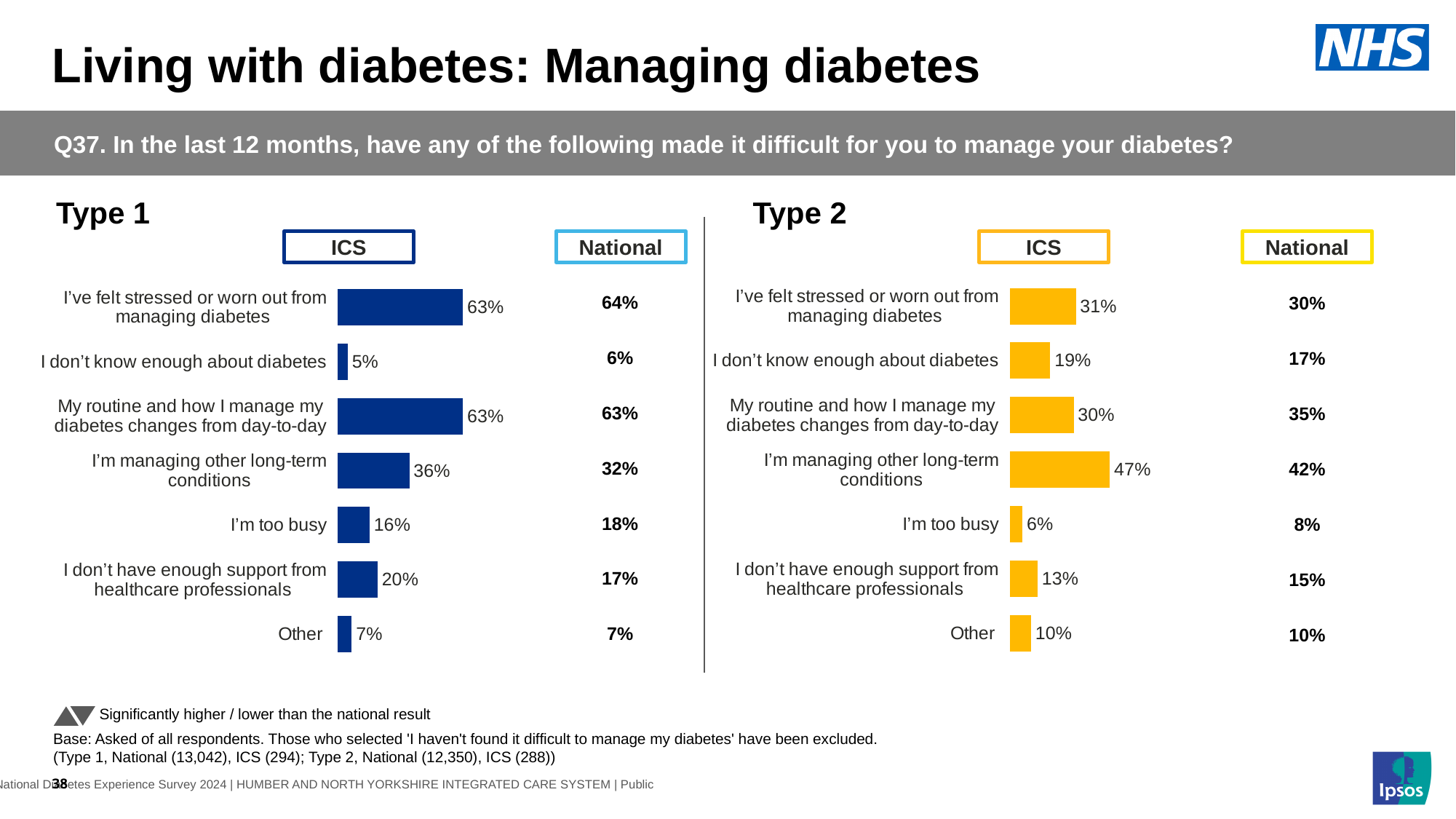
In the Type 1 chart, what is the ICS value for "I'm managing other long-term conditions"? 36% In the Type 1 chart, is the ICS value for "I'm too busy" larger or smaller than the ICS value for "I don't have enough support from healthcare professionals"? smaller In the Type 2 chart, which category has the highest ICS value? I'm managing other long-term conditions In the Type 1 chart, which category has the lowest ICS value? I don't know enough about diabetes In the Type 2 chart, what is the National value for "My routine and how I manage my diabetes changes from day-to-day"? 35% What type of chart is used for the Type 1 ICS results? bar chart How many categories are shown in the Type 2 chart? 7 What colour are the ICS bars in the Type 2 chart? yellow In the Type 1 chart, what is the difference between the ICS and National values for "I'm managing other long-term conditions"? 4 percentage points In the Type 2 chart, what is the difference between the ICS values for "I'm managing other long-term conditions" and "I've felt stressed or worn out from managing diabetes"? 16 percentage points In the Type 2 chart, which category has the lowest ICS value? I'm too busy In the Type 2 chart, what is the ICS value for "I don't know enough about diabetes"? 19%